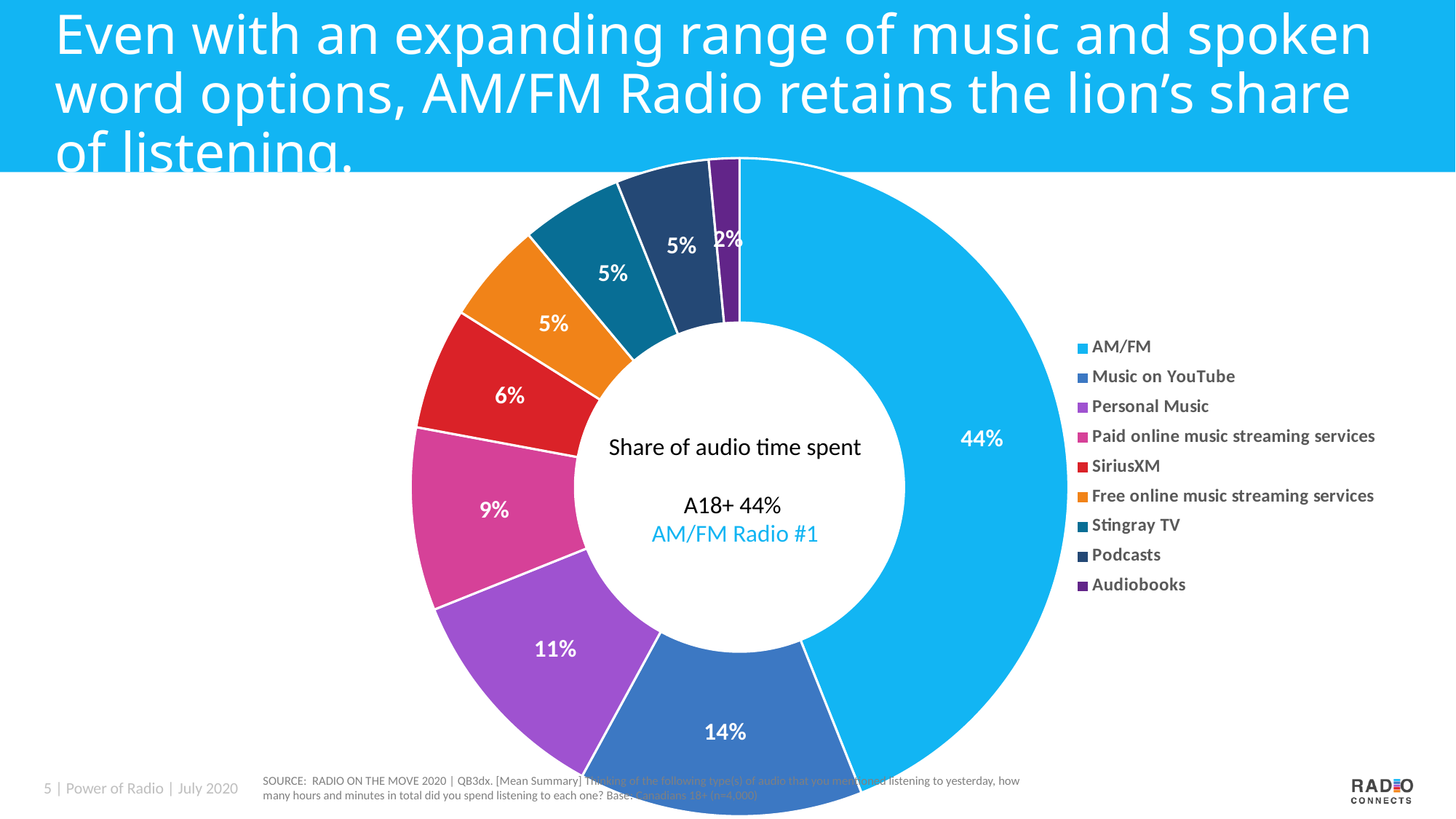
What share of audio time spent does Personal Music have? 11% Which category has the smallest share of audio time spent? Audiobooks How many categories are shown in the chart? 9 What text is shown in the centre of the chart as its title? Share of audio time spent Which category has the largest share of audio time spent? AM/FM What kind of chart is shown on the slide? Donut (pie) chart What share of audio time spent does Music on YouTube have? 14% What is the difference in share between AM/FM and Music on YouTube? 30% What share of audio time spent does SiriusXM have? 6% What share of audio time spent do Audiobooks have? 2% What share of audio time spent does AM/FM have? 44% Which has a larger share of audio time spent, Personal Music or Paid online music streaming services? Personal Music